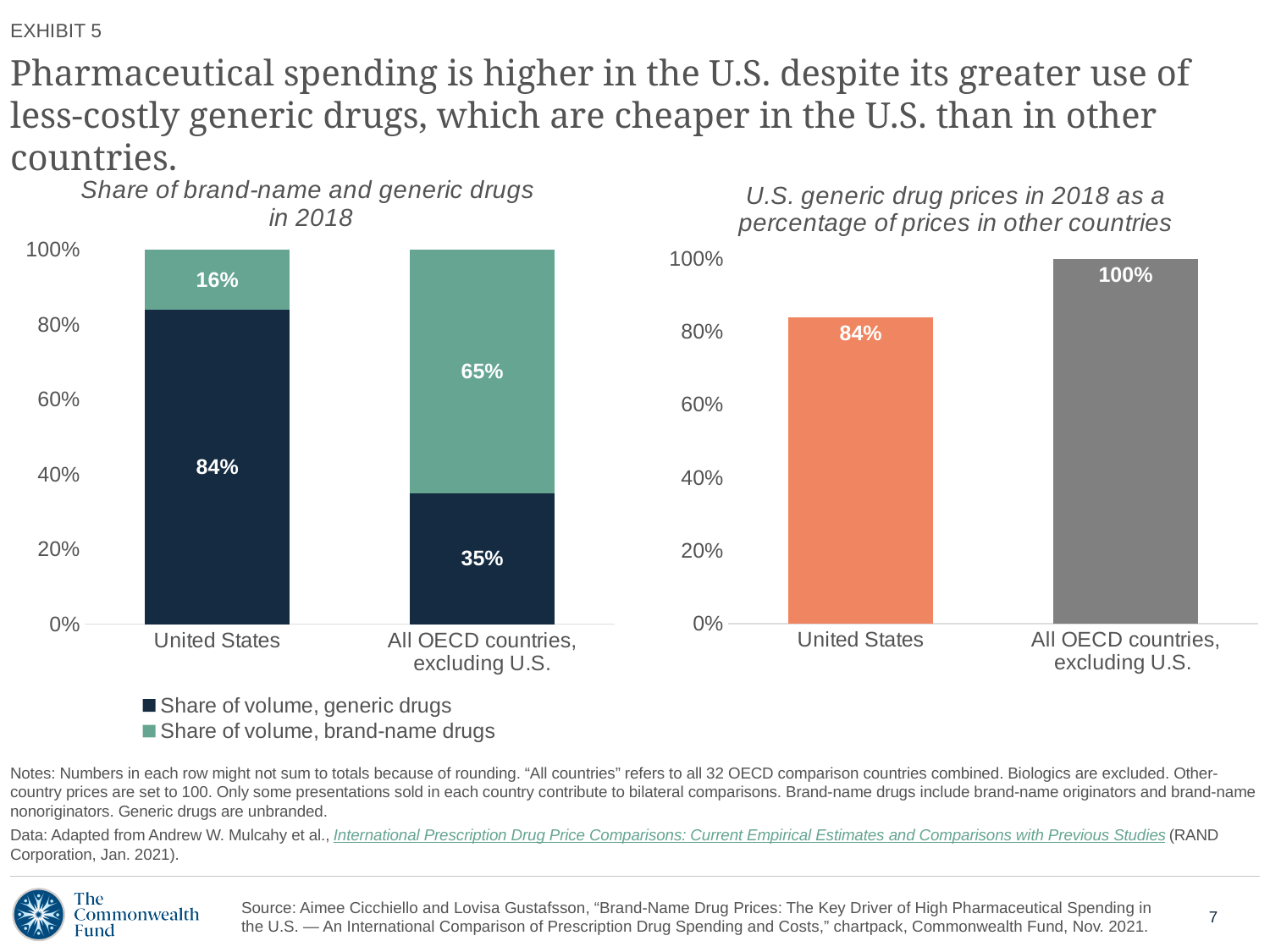
In the left chart 'Share of brand-name and generic drugs in 2018', what is the share of volume of generic drugs for All OECD countries, excluding U.S.? 35% In the left chart 'Share of brand-name and generic drugs in 2018', what is the difference between the generic drug share for the United States and for All OECD countries, excluding U.S.? 49% In the left chart 'Share of brand-name and generic drugs in 2018', what is the share of volume of brand-name drugs for All OECD countries, excluding U.S.? 65% In the right chart 'U.S. generic drug prices in 2018 as a percentage of prices in other countries', how many categories are shown on the x axis? 2 In the right chart 'U.S. generic drug prices in 2018 as a percentage of prices in other countries', which category has the higher value? All OECD countries, excluding U.S. In the left chart 'Share of brand-name and generic drugs in 2018', which has the larger share of volume of brand-name drugs: the United States or All OECD countries, excluding U.S.? All OECD countries, excluding U.S. In the right chart 'U.S. generic drug prices in 2018 as a percentage of prices in other countries', what is the value for the United States? 84% In the left chart 'Share of brand-name and generic drugs in 2018', what is the share of volume of generic drugs for the United States? 84% In the right chart 'U.S. generic drug prices in 2018 as a percentage of prices in other countries', what is the difference between the value for All OECD countries, excluding U.S. and the value for the United States? 16% In the left chart 'Share of brand-name and generic drugs in 2018', how many series does the legend list? 2 In the left chart 'Share of brand-name and generic drugs in 2018', which legend entry is shown in dark navy? Share of volume, generic drugs What kind of chart is the left chart 'Share of brand-name and generic drugs in 2018'? Stacked bar chart